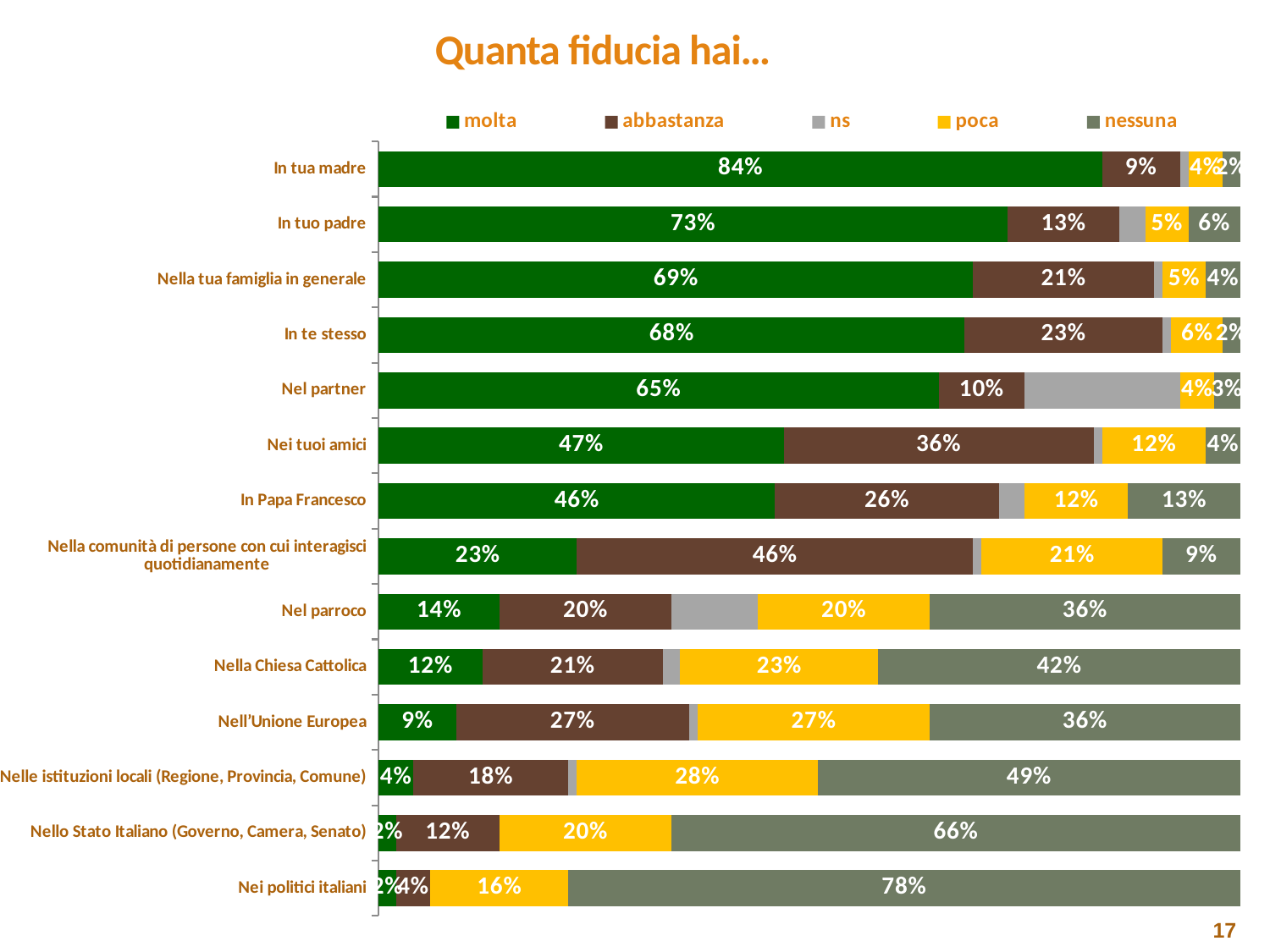
What is the "nessuna" value for "Nello Stato Italiano (Governo, Camera, Senato)"? 66% What is the "poca" value for "Nelle istituzioni locali (Regione, Provincia, Comune)"? 28% How many categories are shown on the chart? 14 Which category has the highest "molta" value? In tua madre What is the "abbastanza" value for "Nella comunità di persone con cui interagisci quotidianamente"? 46% How many series does the legend list? 5 Which category has the highest "nessuna" value? Nei politici italiani What type of chart is shown on the slide? Stacked bar chart What is the difference between the "molta" values for "In tua madre" and "In tuo padre"? 11 percentage points What percentage of respondents answered "molta" for "In tua madre"? 84% Which category has the lowest "molta" value among those labelled? Nello Stato Italiano (Governo, Camera, Senato) and Nei politici italiani (tied at 2%) Which has a larger "nessuna" value: "Nella Chiesa Cattolica" or "Nel parroco"? Nella Chiesa Cattolica